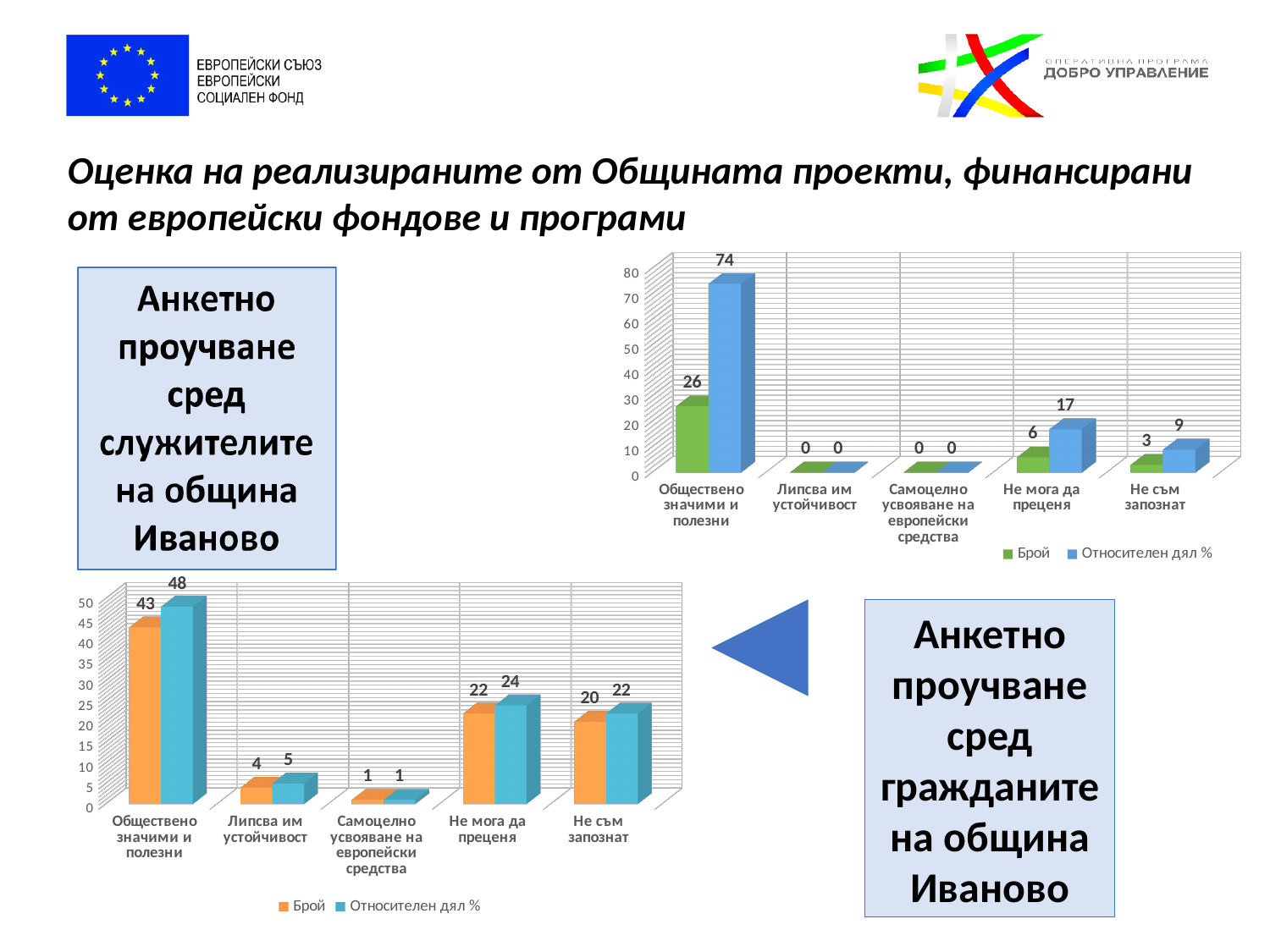
In the top-right chart, what is the difference between the "Относителен дял %" values for "Не мога да преценя" and "Не съм запознат"? 8 In the bottom-left chart, what is the value of "Брой" for "Не съм запознат"? 20 In the top-right chart, what is the value of "Брой" for "Обществено значими и полезни"? 26 In the bottom-left chart, which category has the lowest "Брой" value? Самоцелно усвояване на европейски средства How many categories are shown on the x axis of the bottom-left chart? 5 In the top-right chart, what is the value of "Относителен дял %" for "Не мога да преценя"? 17 In the top-right chart, which category has the highest "Относителен дял %" value? Обществено значими и полезни How many series does the legend of the top-right chart list? 2 In the bottom-left chart, which is larger: the "Брой" value for "Не мога да преценя" or for "Не съм запознат"? Не мога да преценя In the bottom-left chart, what is the value of "Относителен дял %" for "Липсва им устойчивост"? 5 In the bottom-left chart, what is the difference between the "Относителен дял %" and "Брой" values for "Обществено значими и полезни"? 5 What type of chart is the bottom-left chart? Bar chart